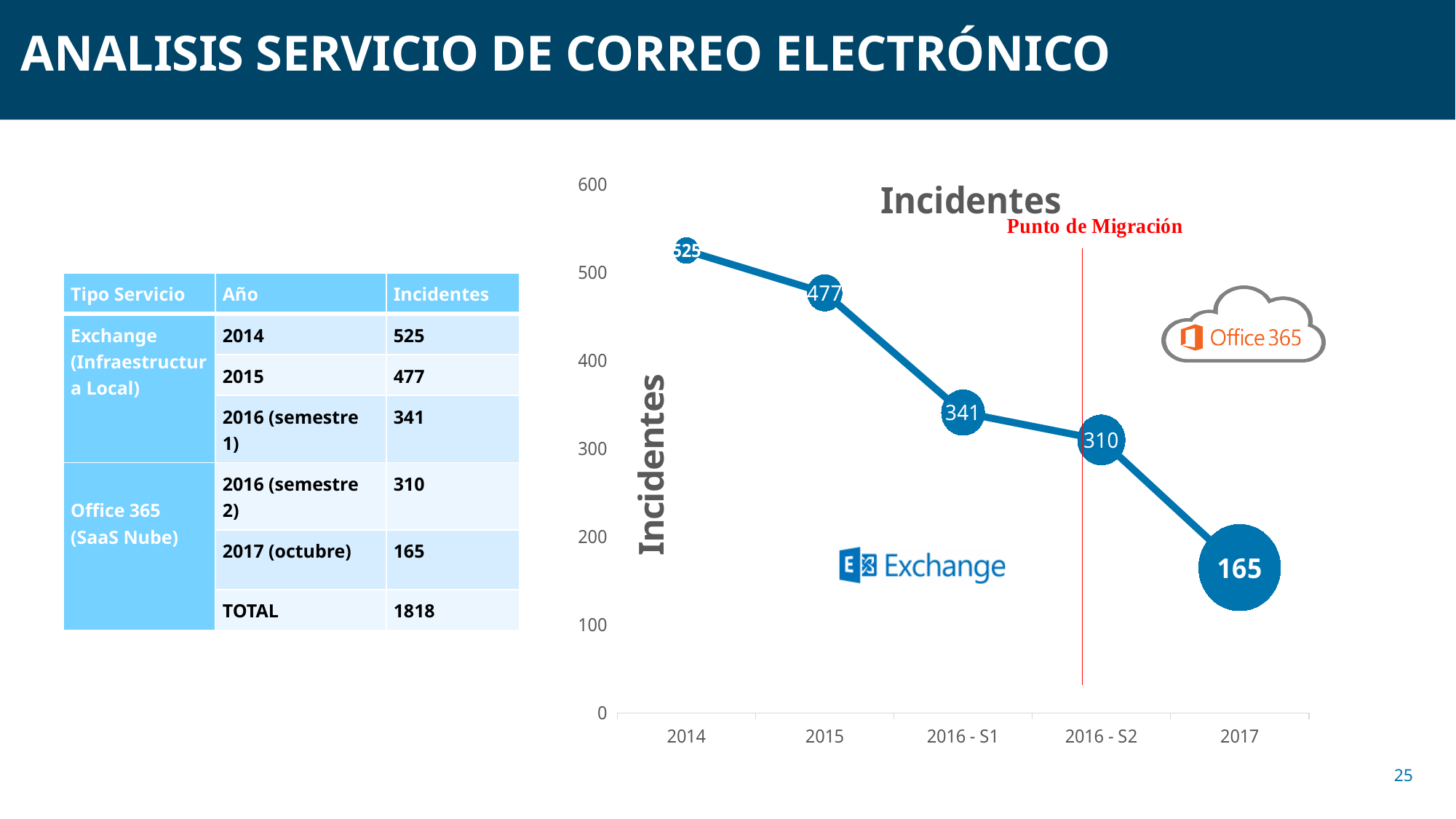
Which is larger in the Incidentes chart, the value for 2015 or the value for 2016 - S2? 2015 What is the difference between the values for 2016 - S1 and 2016 - S2 in the Incidentes chart? 31 What is the value for 2015 in the Incidentes chart? 477 Which category has the highest value in the Incidentes chart? 2014 Do the values in the Incidentes chart rise or fall from 2014 to 2017? fall Which category has the lowest value in the Incidentes chart? 2017 What is the value for 2017 in the Incidentes chart? 165 What is the value for 2014 in the Incidentes chart? 525 What is the difference between the values for 2014 and 2017 in the Incidentes chart? 360 How many data points are plotted in the Incidentes chart? 5 What is the value for 2016 - S1 in the Incidentes chart? 341 What kind of chart is the Incidentes chart? line chart